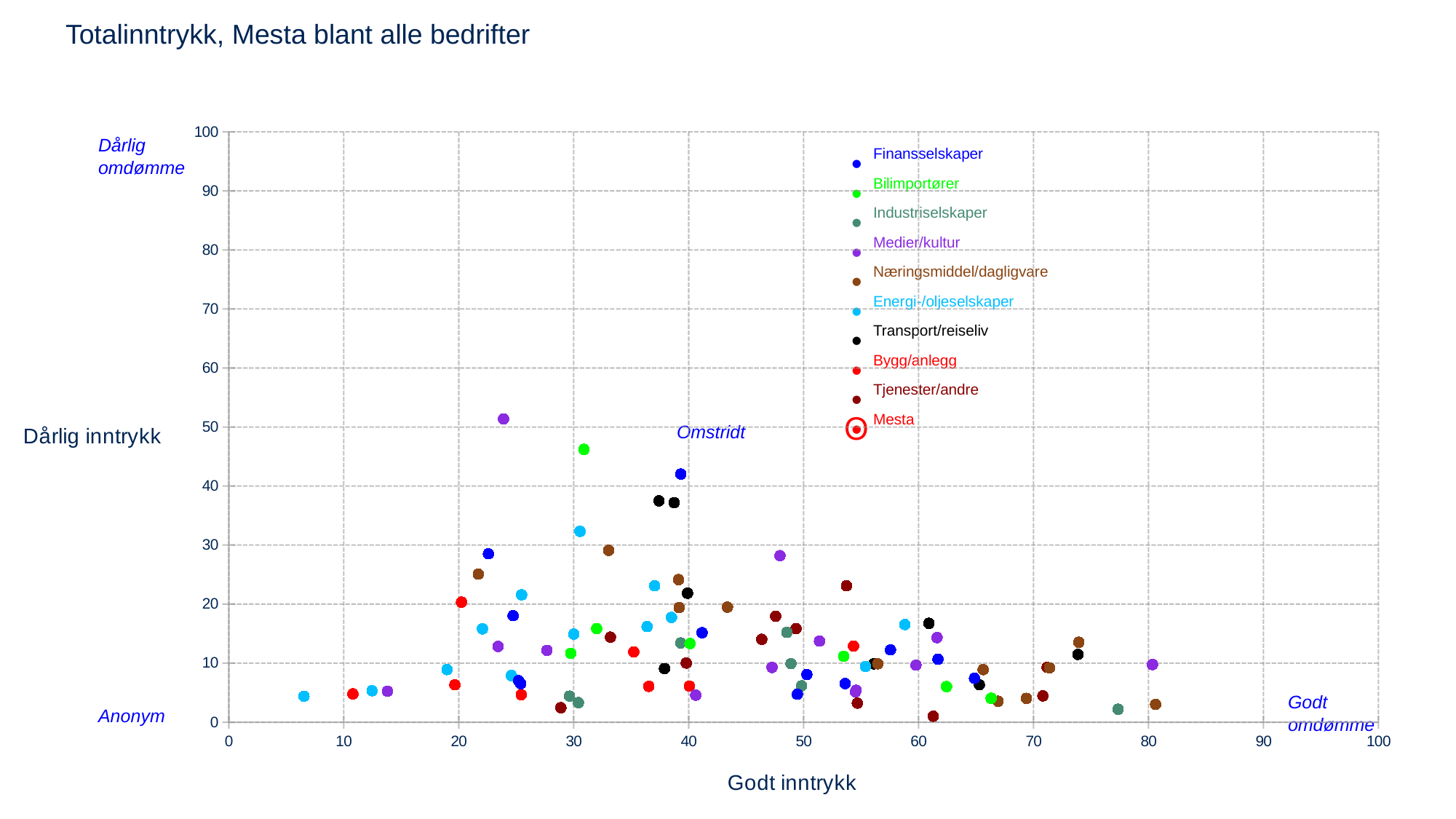
Which series does the highest point on the chart belong to? Medier/kultur Is the leftmost point on the chart greater or less than 10 on the horizontal axis? less Is the highest point on the chart greater or less than 40 on the vertical axis? greater What is the title of the chart? Totalinntrykk, Mesta blant alle bedrifter What kind of chart is shown on the slide? scatter chart Is the highest Bilimportører point greater or less than 40 on the vertical axis? greater What is the label of the horizontal axis? Godt inntrykk How many series does the legend list? 10